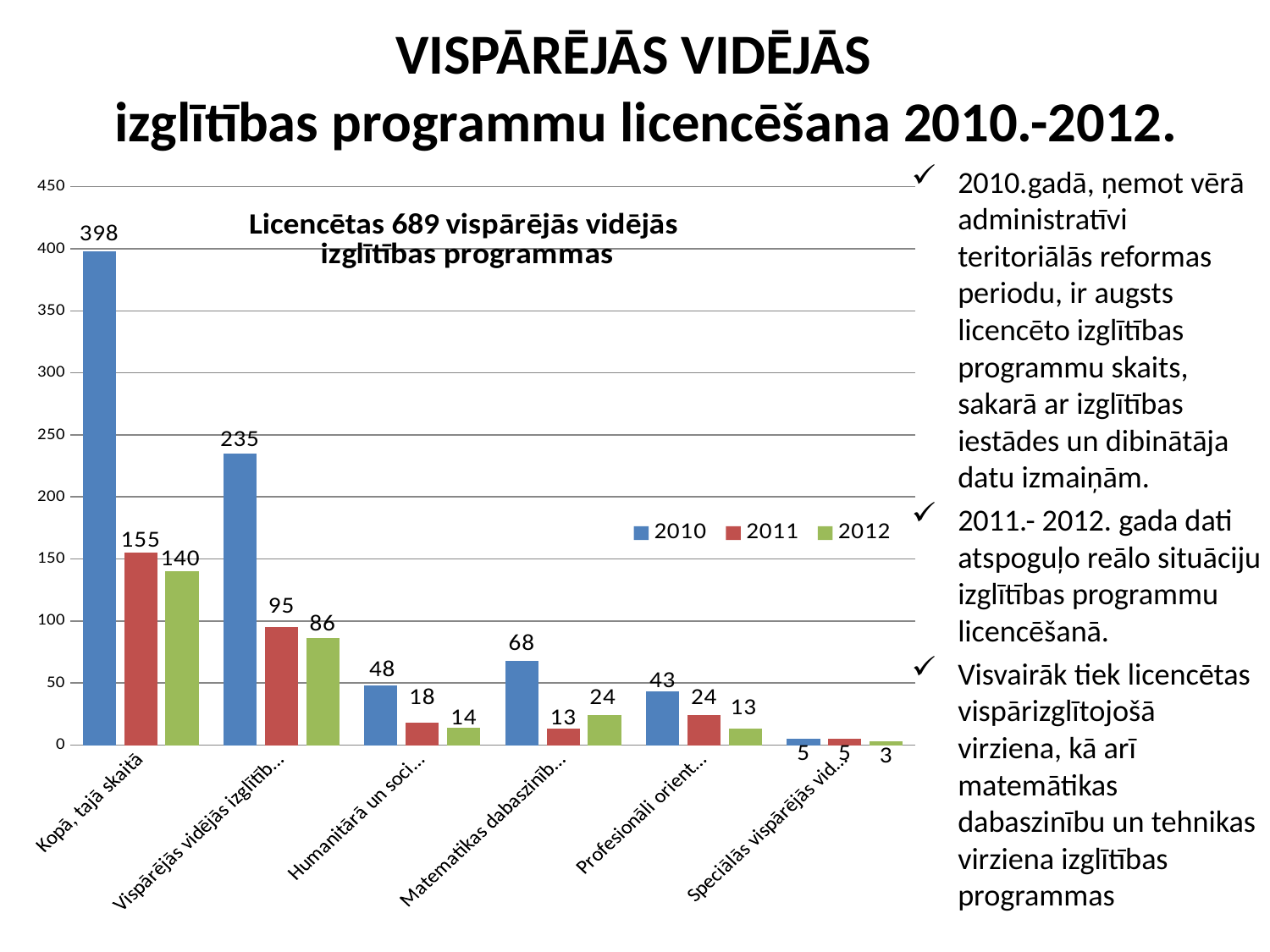
What is the 2012 value for the category "Kopā, tajā skaitā"? 140 What is the 2010 value for the category "Kopā, tajā skaitā"? 398 Which category has the lowest 2012 value? Speciālās vispārējās vid... How many series does the legend list? 3 What kind of chart is shown on the slide? Bar chart What is the difference between the 2010 and 2011 values for "Kopā, tajā skaitā"? 243 What is the title printed inside the chart area? Licencētas 689 vispārējās vidējās izglītības programmas Which is larger for the category beginning "Profesionāli orient...": the 2011 value or the 2012 value? 2011 How many categories are shown on the x axis? 6 Which category has the highest 2010 value? Kopā, tajā skaitā What is the 2012 value for the category beginning "Matematikas dabaszinīb..."? 24 What is the 2011 value for the category beginning "Humanitārā un soci..."? 18